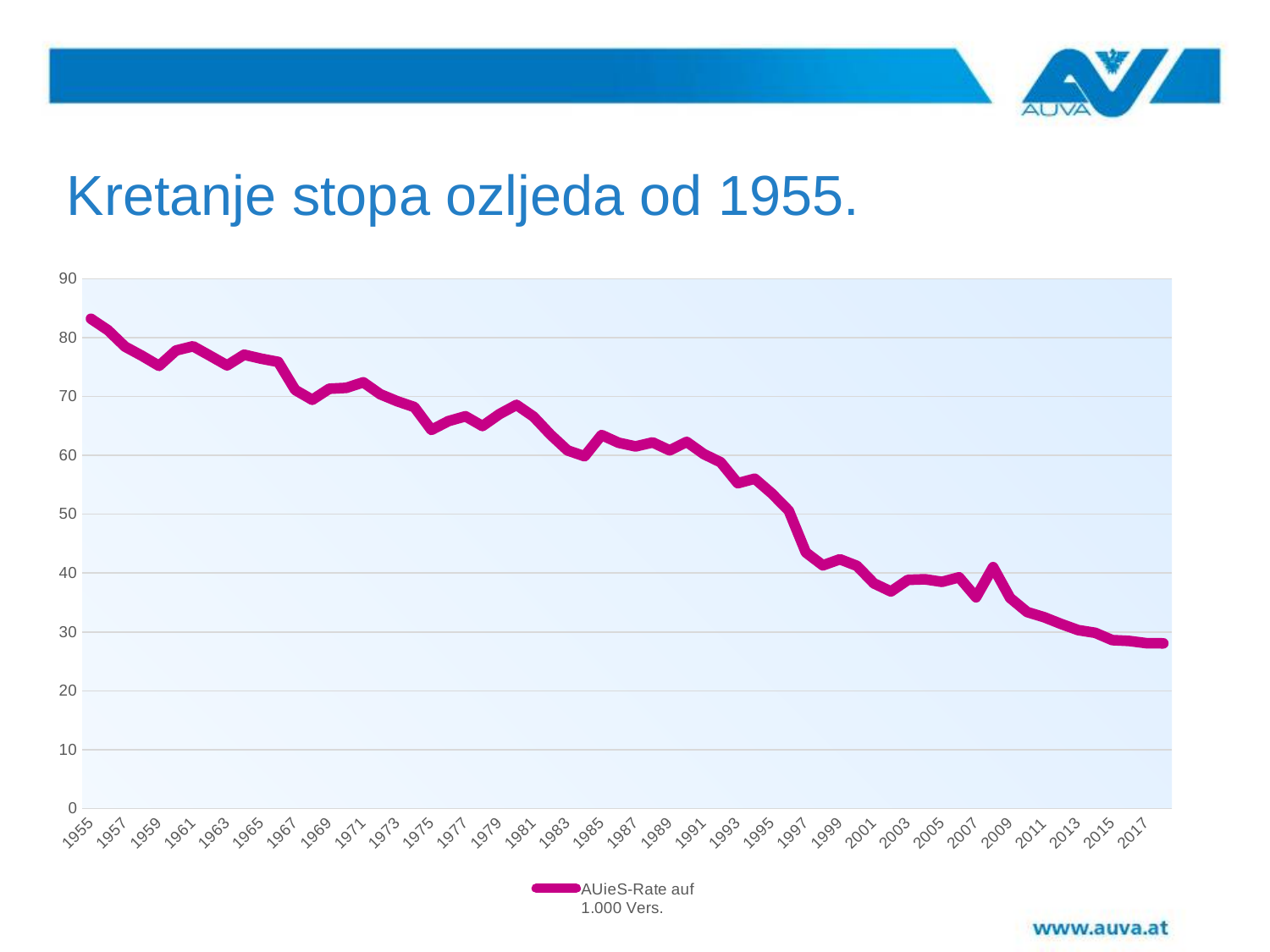
Is the value for 1975 greater or less than 60? greater Which year has the highest value on the chart? 1955 Which year has the larger value, 1985 or 1995? 1985 What series name does the legend show? AUieS-Rate auf 1.000 Vers. Is the value for 1955 greater or less than 80? greater Is the value for 2003 greater or less than 40? less How many series does the legend list? 1 What is the title of the chart on the slide? Kretanje stopa ozljeda od 1955. Do the values generally rise or fall from 1955 to 2017? fall What kind of chart is shown on the slide? line chart